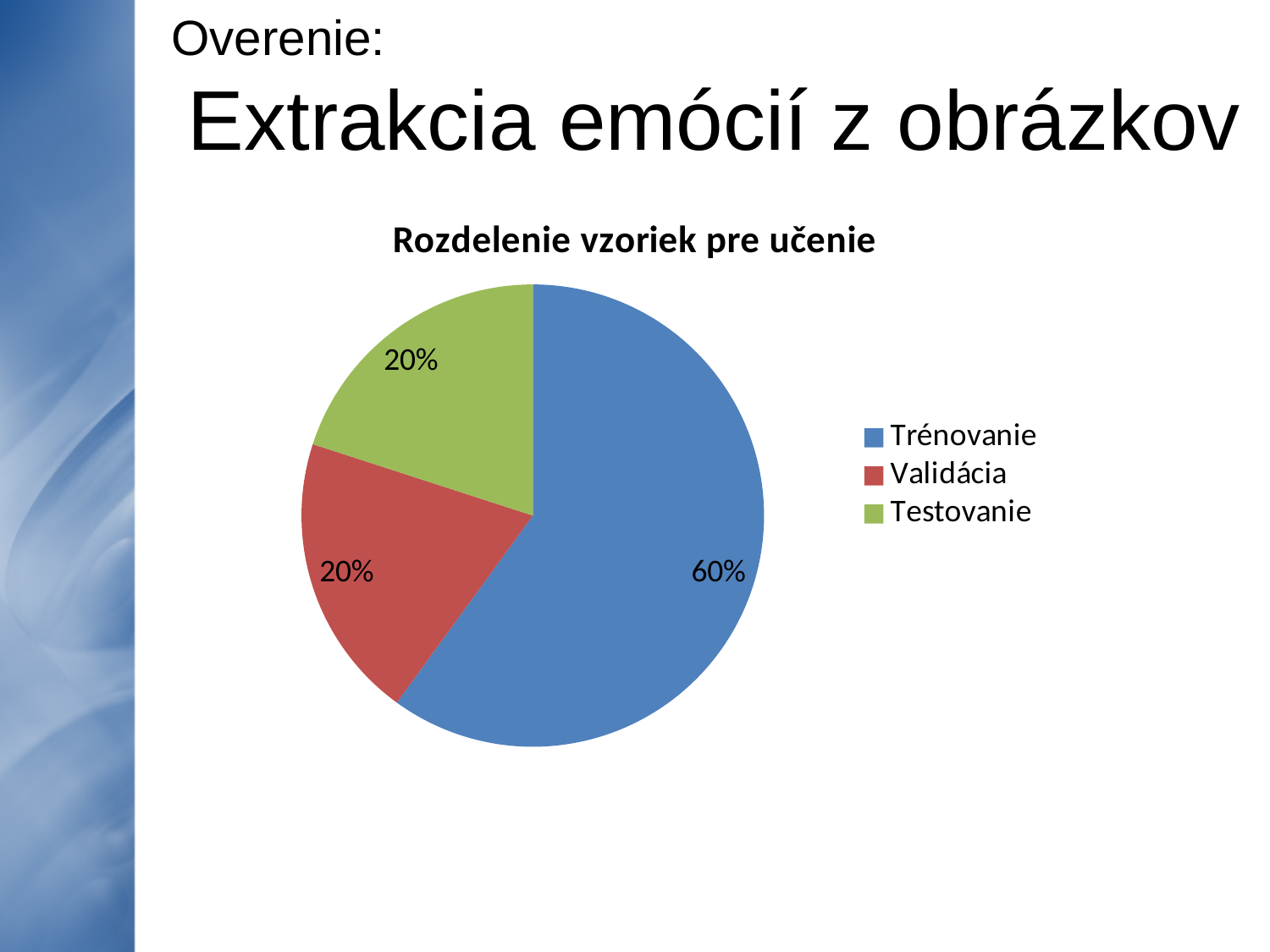
Is the share for Trénovanie greater or less than 50%? greater What share of the pie does Testovanie take? 20% What is the difference between the Trénovanie share and the Validácia share? 40% What share of the pie does Trénovanie take? 60% How many entries does the legend list? 3 How many slices does the pie chart have? 3 What share of the pie does Validácia take? 20% What is the title of the chart? Rozdelenie vzoriek pre učenie What kind of chart is shown on the slide? pie chart Which category has the largest slice of the pie? Trénovanie Which is larger, the Trénovanie slice or the Testovanie slice? Trénovanie Which colour represents Validácia in the pie chart? red